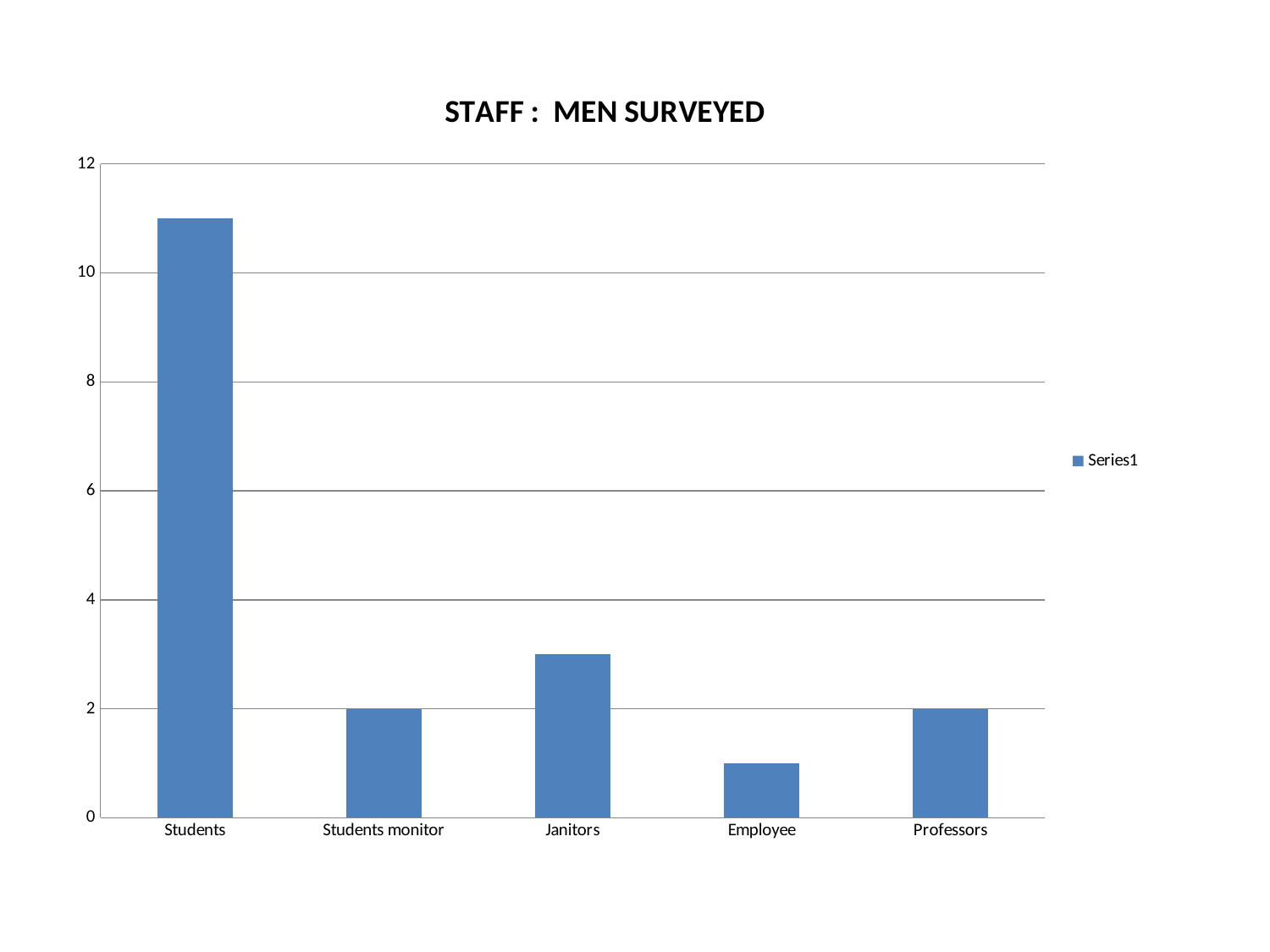
How many series does the legend list? 1 Which category has the highest value? Students Is the value for Employee greater or less than 2? less Which category has the lowest value? Employee Is the value for Janitors greater or less than 4? less How many categories are shown on the x axis? 5 What is the value for Students monitor? 2 What is the title of the chart? STAFF : MEN SURVEYED Which is larger, the value for Janitors or the value for Employee? Janitors Is the value for Students greater or less than 10? greater What type of chart is shown on the slide? bar chart What is the value for Professors? 2